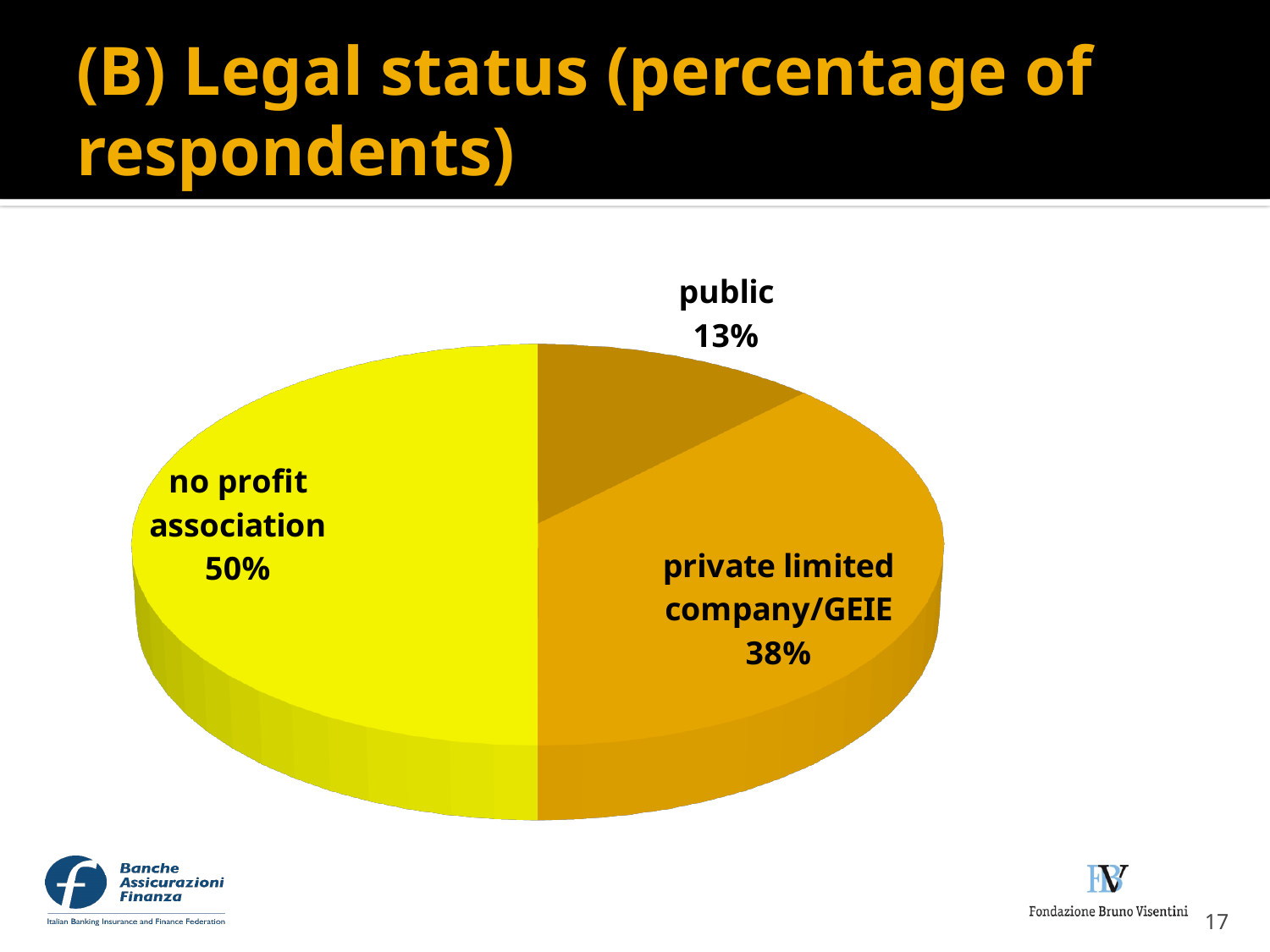
What colour is the no profit association slice? yellow Which is larger, the share for public or the share for private limited company/GEIE? private limited company/GEIE What percentage of respondents are no profit associations? 50% What is the difference in percentage points between private limited company/GEIE and public? 25 Which legal status has the smallest share of respondents? public What percentage of respondents are private limited company/GEIE? 38% What type of chart is shown on the slide? pie chart How many legal status categories are shown in the pie chart? 3 What is the difference in percentage points between no profit association and private limited company/GEIE? 12 What is the title of the slide containing the chart? (B) Legal status (percentage of respondents) Which legal status has the largest share of respondents? no profit association What percentage of respondents have public legal status? 13%